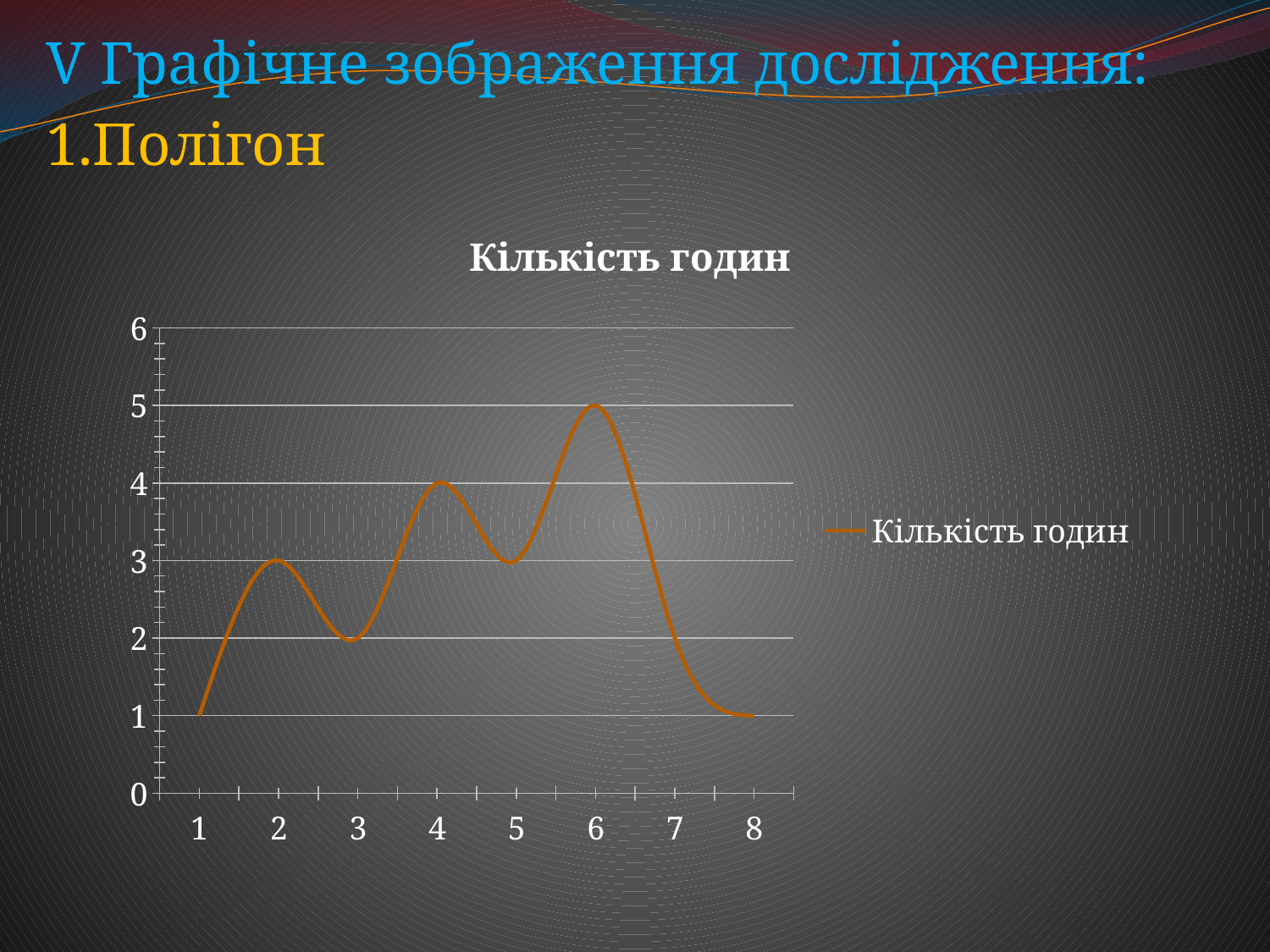
What is the value for category 4 in the chart? 4 How many series does the legend list? 1 Which has a larger value, category 4 or category 5? 4 What is the value for category 6 in the chart? 5 What is the value for category 8 in the chart? 1 How many categories are shown on the x axis of the chart? 8 Do the values rise or fall from category 6 to category 8? fall What is the difference between the values for category 6 and category 3? 3 What kind of chart is shown on the slide? line chart Is the value for category 6 greater or less than 4? greater What is the value for category 2 in the chart? 3 Which category has the highest value in the chart? 6